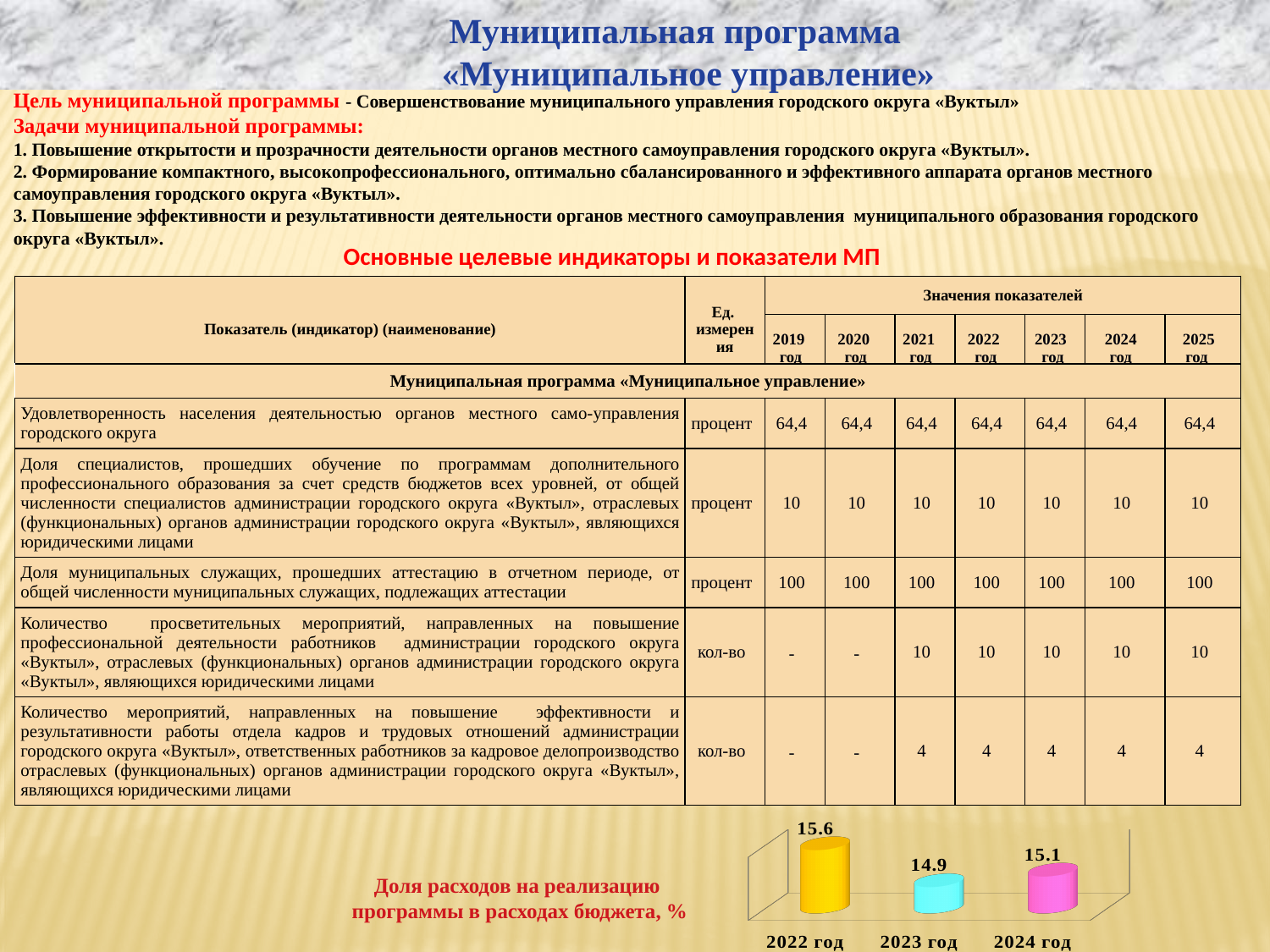
What is the value for 2022 год in the chart 'Доля расходов на реализацию программы в расходах бюджета, %'? 15.6 What colour is the bar for 2022 год in the chart 'Доля расходов на реализацию программы в расходах бюджета, %'? yellow How many years are shown in the chart 'Доля расходов на реализацию программы в расходах бюджета, %'? 3 What kind of chart is 'Доля расходов на реализацию программы в расходах бюджета, %'? bar chart In the chart 'Доля расходов на реализацию программы в расходах бюджета, %', what is the difference between the values for 2024 год and 2023 год? 0.2 Which year has the lowest value in the chart 'Доля расходов на реализацию программы в расходах бюджета, %'? 2023 год Which year has the highest value in the chart 'Доля расходов на реализацию программы в расходах бюджета, %'? 2022 год In the chart 'Доля расходов на реализацию программы в расходах бюджета, %', which is larger: the value for 2022 год or 2024 год? 2022 год In the chart 'Доля расходов на реализацию программы в расходах бюджета, %', what is the difference between the values for 2022 год and 2023 год? 0.7 In the chart 'Доля расходов на реализацию программы в расходах бюджета, %', does the value rise or fall from 2022 год to 2023 год? fall What is the value for 2023 год in the chart 'Доля расходов на реализацию программы в расходах бюджета, %'? 14.9 What is the value for 2024 год in the chart 'Доля расходов на реализацию программы в расходах бюджета, %'? 15.1